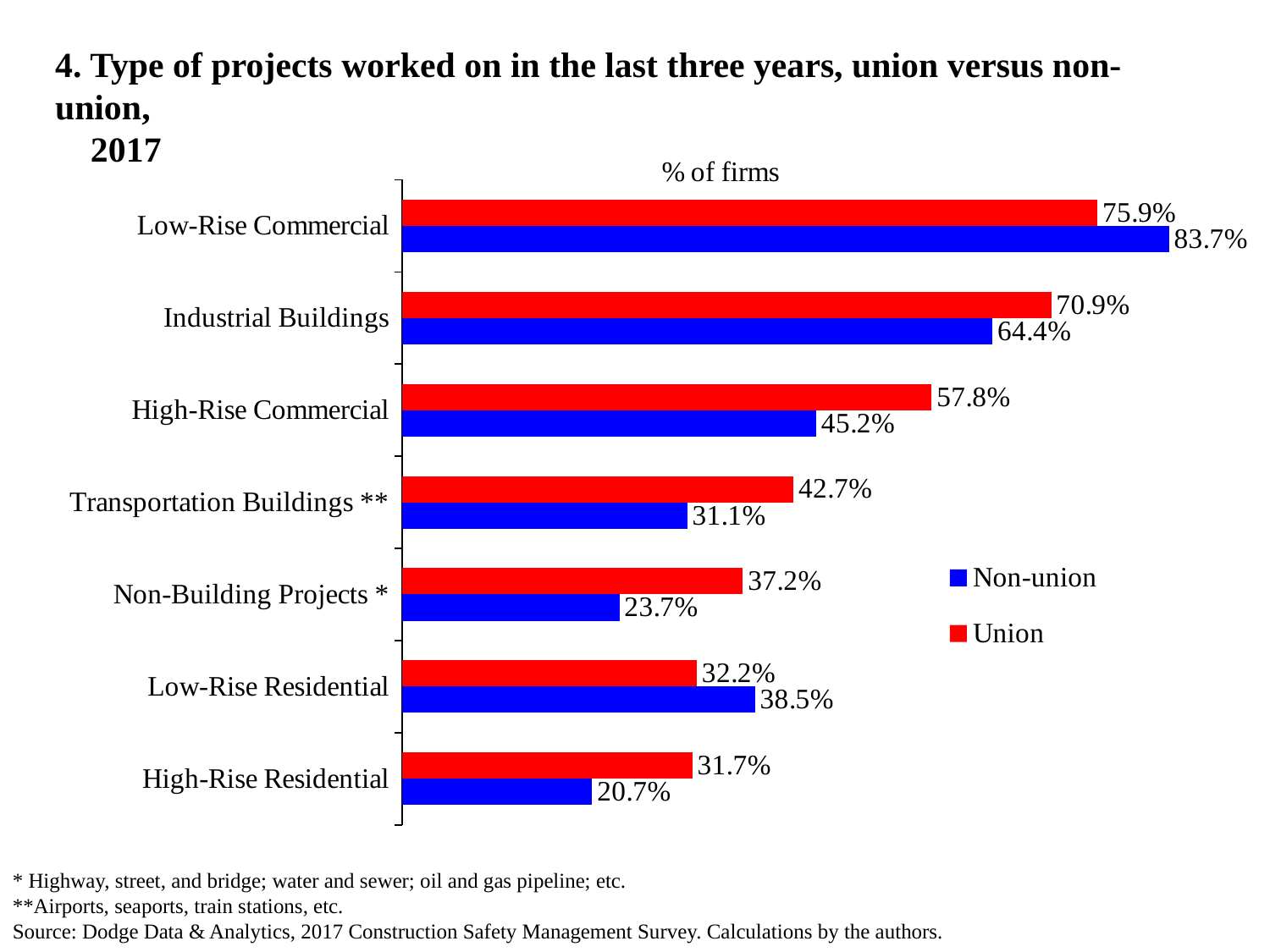
Which project type has the highest Non-union value? Low-Rise Commercial What percentage of non-union firms worked on High-Rise Residential projects? 20.7% How many series does the legend list? 2 What percentage of union firms worked on Low-Rise Commercial projects? 75.9% What kind of chart is shown on the slide? Bar chart For Industrial Buildings, which is larger: the Union value or the Non-union value? Union For Low-Rise Residential, which is larger: the Union value or the Non-union value? Non-union What is the difference between the Union and Non-union values for High-Rise Commercial? 12.6% What is the Union value for Transportation Buildings? 42.7% Which project type has the lowest Union value? High-Rise Residential What is the difference between the Non-union and Union values for Low-Rise Commercial? 7.8% How many project types are shown in the chart? 7